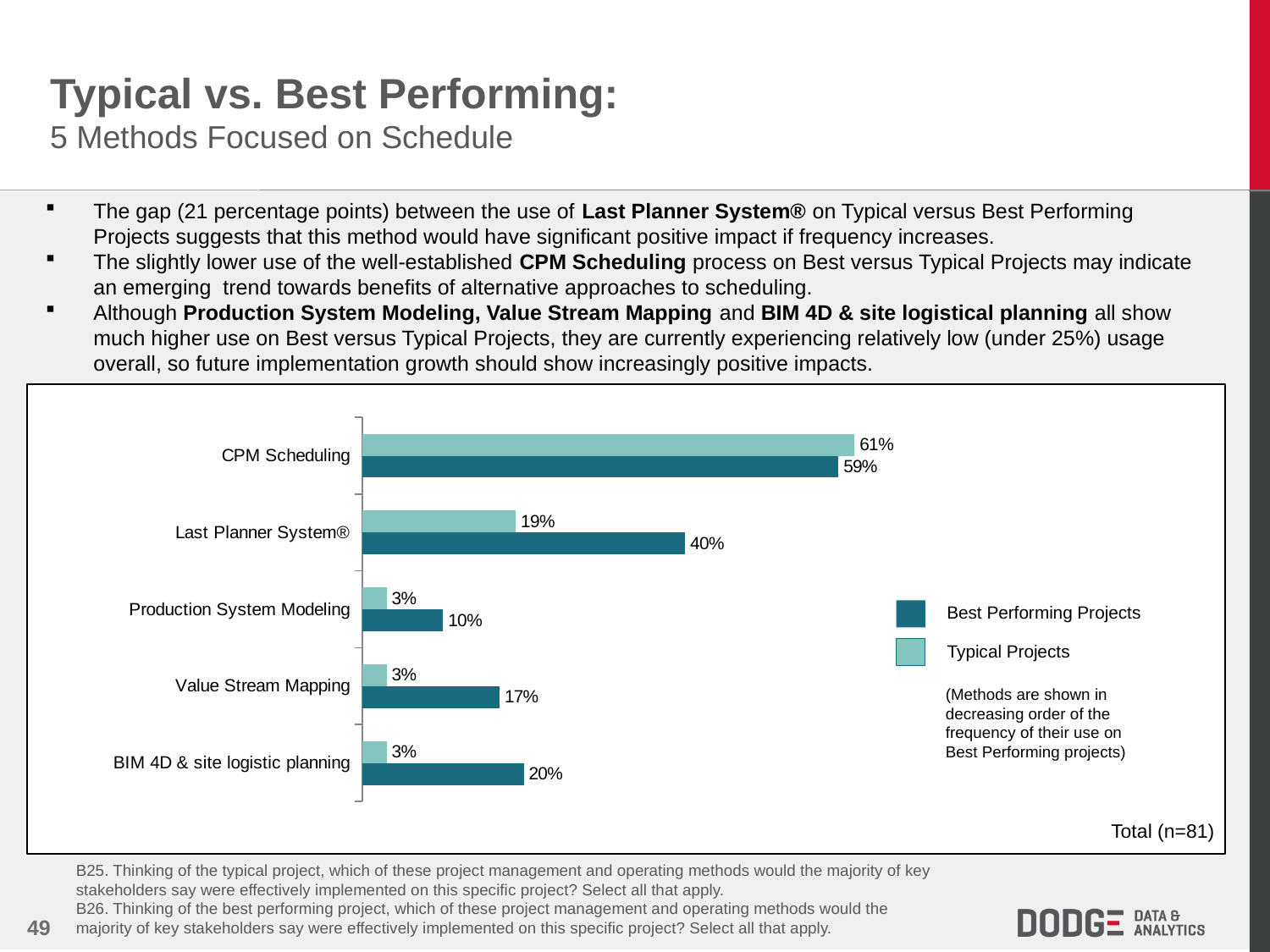
What is the value for Typical Projects for Value Stream Mapping? 3% Which method has the highest value for Best Performing Projects? CPM Scheduling For Production System Modeling, which is larger: Best Performing Projects or Typical Projects? Best Performing Projects What is the value for Best Performing Projects for Last Planner System®? 40% How many methods are shown in the chart? 5 How many series does the legend list? 2 What is the value for Best Performing Projects for BIM 4D & site logistic planning? 20% Which method has the lowest value for Best Performing Projects? Production System Modeling What kind of chart is shown on the slide? Bar chart What is the value for Typical Projects for CPM Scheduling? 61% What is the difference between Typical Projects and Best Performing Projects for CPM Scheduling? 2 percentage points What is the difference between Best Performing Projects and Typical Projects for Last Planner System®? 21 percentage points